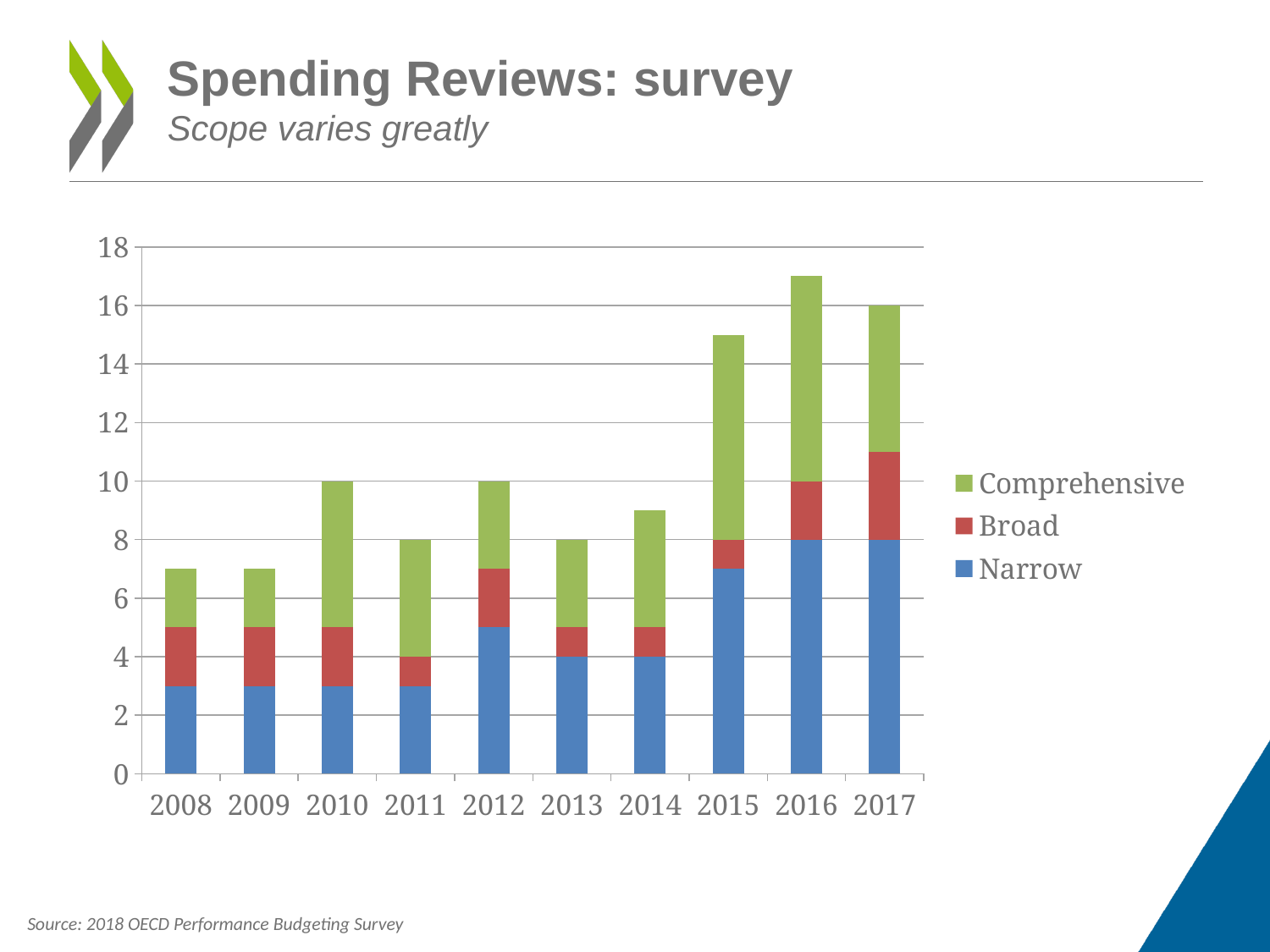
Which has the larger total bar, 2014 or 2015? 2015 How many series does the legend list? 3 What is the total height of the bar for 2017? 16 What kind of chart is shown on the slide? Stacked bar chart What is the value of the Narrow segment for 2013? 4 Is the total for 2016 greater or less than 16? greater What is the total height of the bar for 2010? 10 Is the total for 2008 greater or less than 8? less How many years are shown on the x axis? 10 Which year has the highest total bar? 2016 Which series is shown in blue in the legend? Narrow What is the value of the Narrow segment for 2016? 8